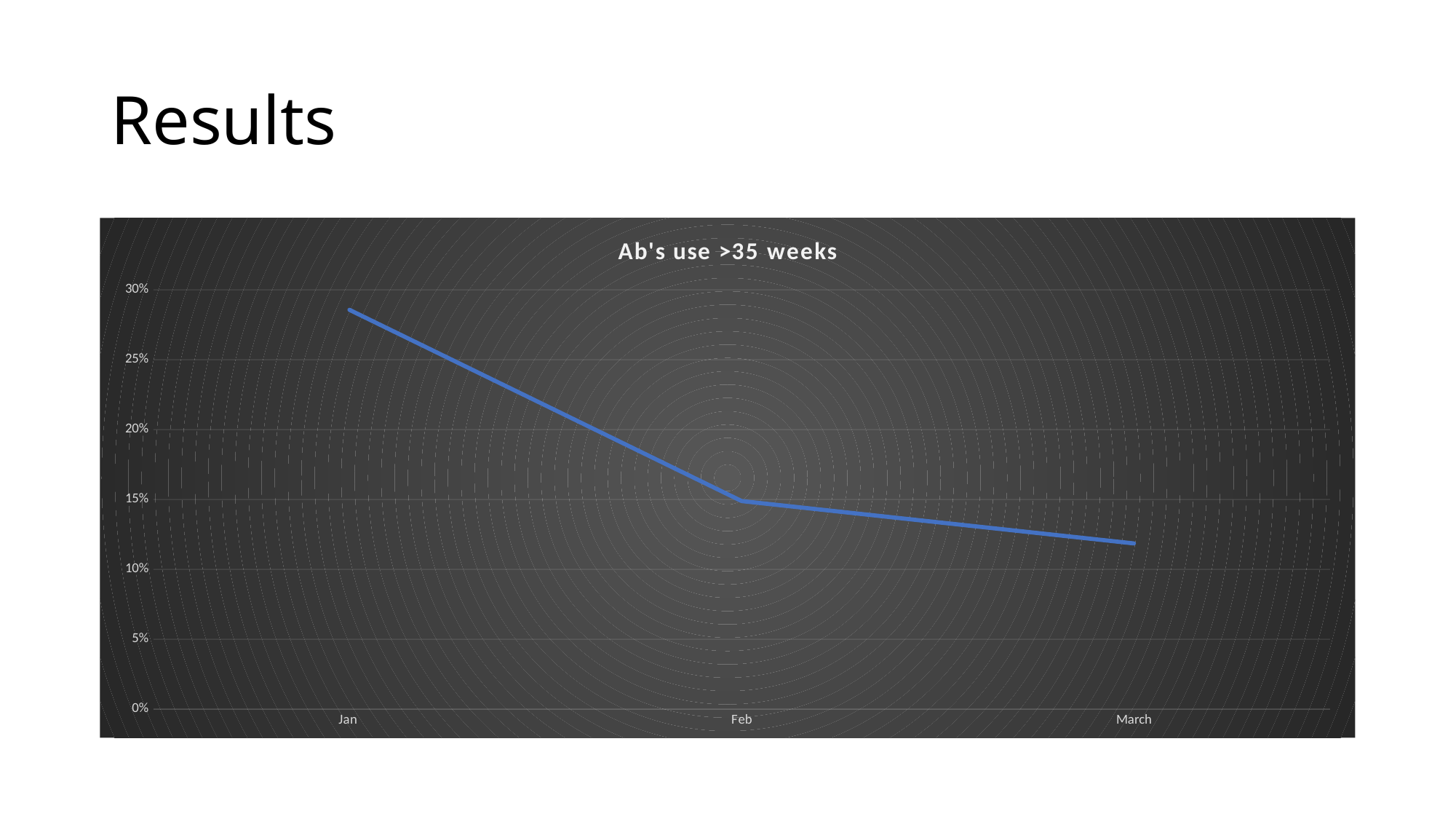
Which is larger, the value for Feb or the value for March? Feb Which is larger, the value for Jan or the value for Feb? Jan Which month has the highest value? Jan Which month has the lowest value? March Is the value for March greater or less than 10%? greater Is the value for Jan greater or less than 25%? greater What kind of chart is shown on the slide? line chart Is the value for March greater or less than 15%? less What is the title of the chart? Ab's use >35 weeks Do the values rise or fall from Jan to March? fall How many months are plotted on the x axis? 3